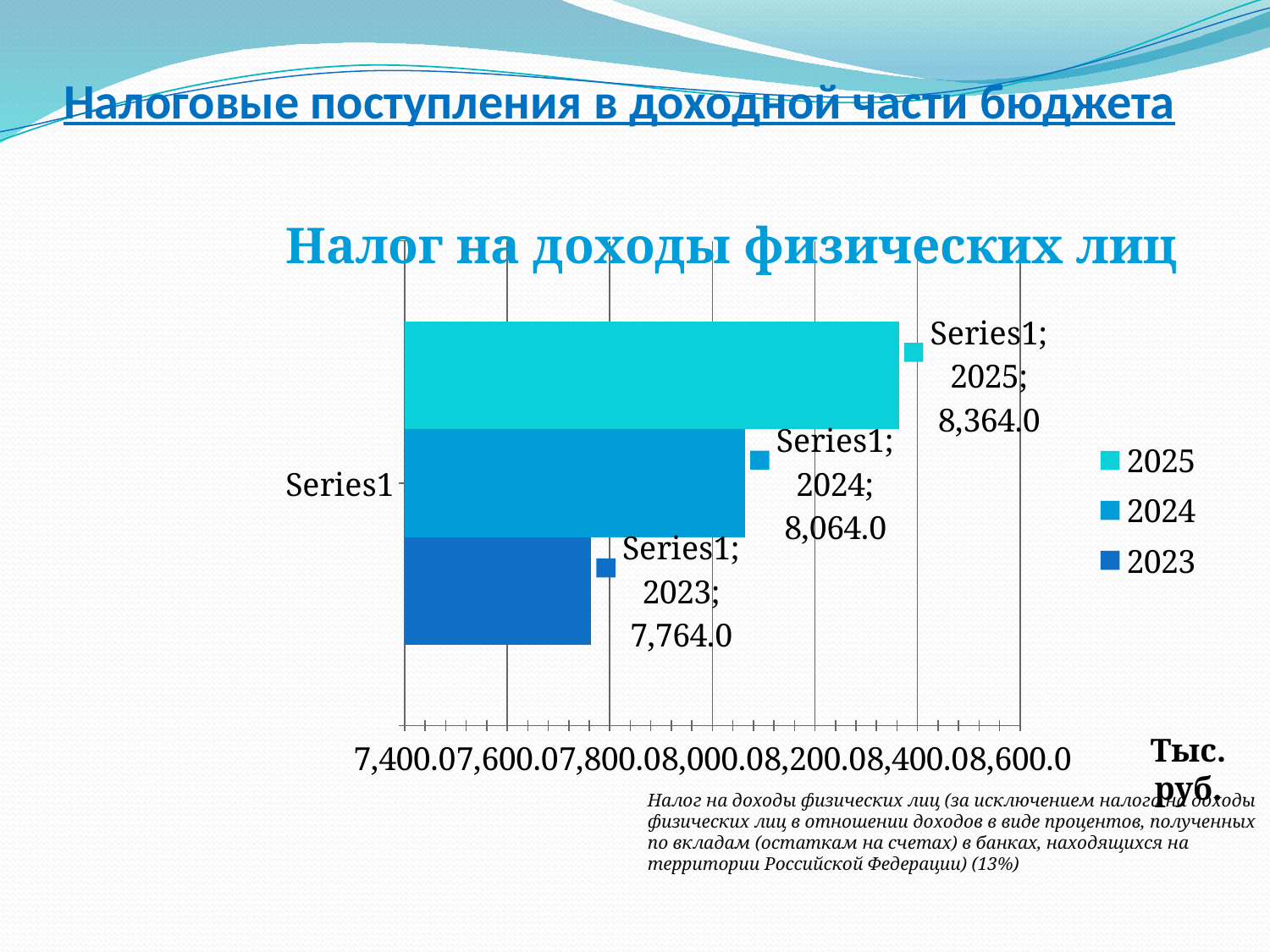
Which year has the lowest value in the chart? 2023 What is the title of the chart? Налог на доходы физических лиц What is the value for 2025 in the chart? 8,364.0 What is the difference between the values for 2025 and 2023? 600.0 Which is larger, the value for 2024 or the value for 2023? 2024 What is the value for 2024 in the chart? 8,064.0 What is the value for 2023 in the chart? 7,764.0 What is the difference between the values for 2025 and 2024? 300.0 Is the value for 2024 greater or less than 8,000.0? greater Which year has the highest value in the chart? 2025 What kind of chart is shown on the slide? bar chart How many series does the legend list? 3